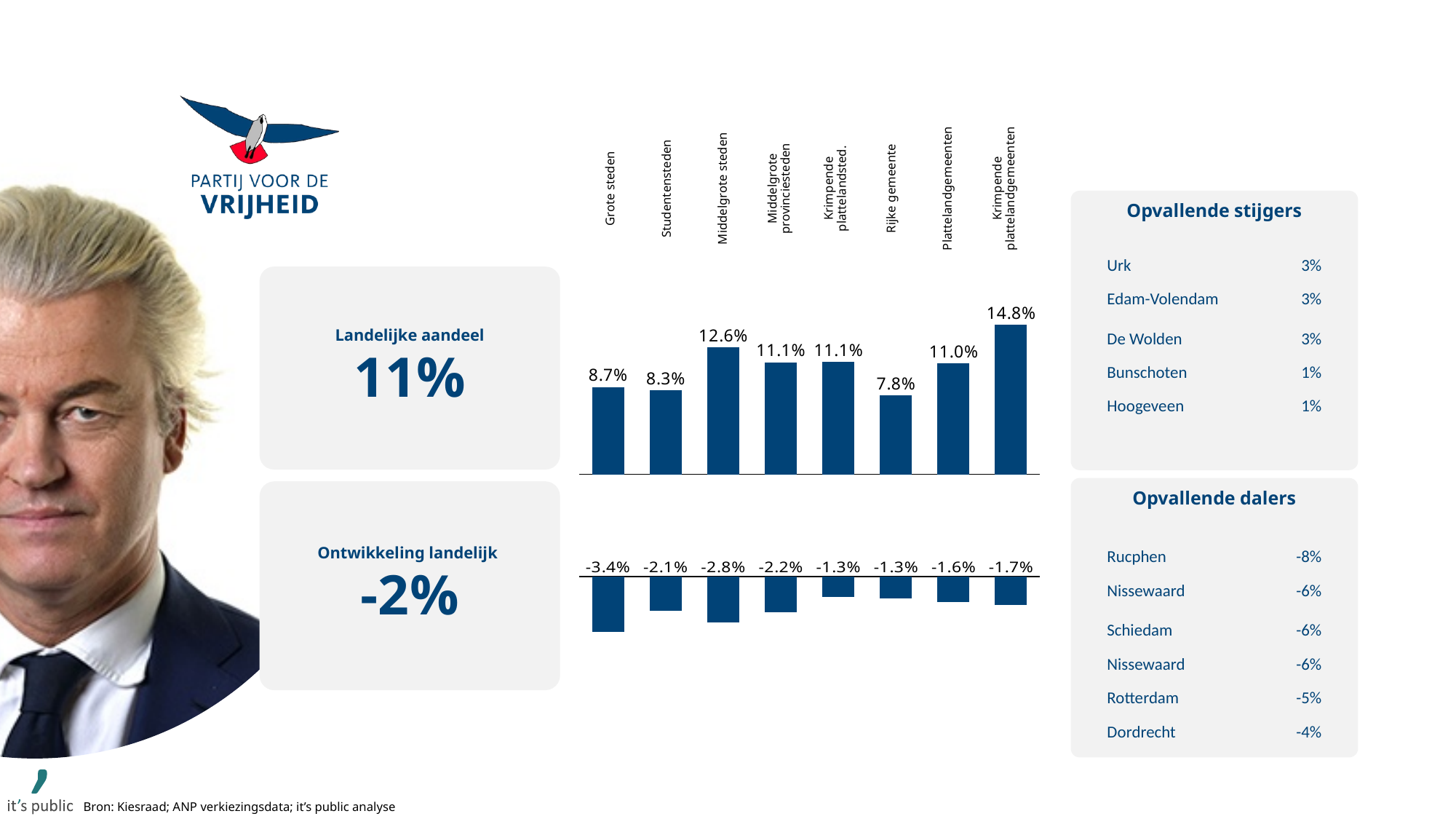
In the bottom chart (Ontwikkeling landelijk), what is the value for Plattelandgemeenten? -1.6% In the top chart (Landelijke aandeel), what is the difference between Krimpende plattelandgemeenten and Grote steden? 6.1% In the bottom chart (Ontwikkeling landelijk), what is the value for Grote steden? -3.4% In the bottom chart (Ontwikkeling landelijk), which is larger: the value for Studentensteden or the value for Middelgrote steden? Studentensteden In the top chart (Landelijke aandeel), which category has the highest value? Krimpende plattelandgemeenten In the top chart (Landelijke aandeel), which is larger: the value for Grote steden or the value for Studentensteden? Grote steden In the top chart (Landelijke aandeel), what is the value for Middelgrote steden? 12.6% In the top chart (Landelijke aandeel), what is the value for Rijke gemeente? 7.8% How many categories are shown in the top chart (Landelijke aandeel)? 8 What kind of chart is the top chart (Landelijke aandeel)? Bar chart In the top chart (Landelijke aandeel), which category has the lowest value? Rijke gemeente In the bottom chart (Ontwikkeling landelijk), which category has the lowest (most negative) value? Grote steden